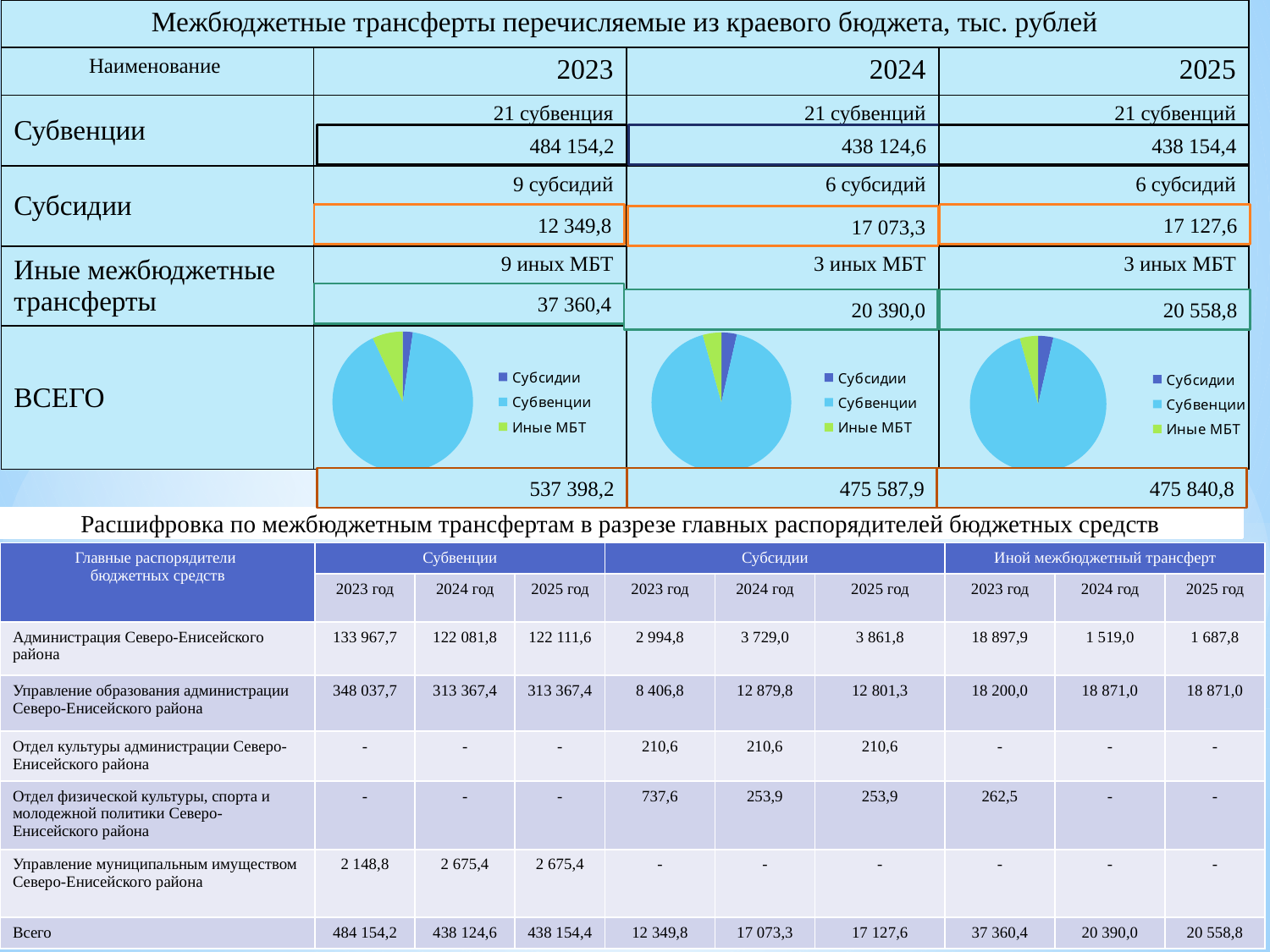
Which colour represents Иные МБТ in the pie chart legends? green What is the difference between the Субвенции and Субсидии values shown for the 2025 pie chart, in тыс. рублей? 421 026,8 How many entries does the legend of the 2024 pie chart list? 3 What is the total of all slices in the 2024 pie chart, in тыс. рублей? 475 587,9 How many pie charts are shown on the slide? 3 In the 2025 pie chart, which slice is larger: Субвенции or Иные МБТ? Субвенции In the 2023 pie chart, which category has the smallest slice? Субсидии What kind of chart is shown in the ВСЕГО row for 2023? pie chart What is the value of the Субвенции slice in the 2023 pie chart, in тыс. рублей? 484 154,2 What is the value of the Иные МБТ slice in the 2025 pie chart, in тыс. рублей? 20 558,8 Which legend entry is listed first in the 2023 pie chart legend? Субсидии In the 2023 pie chart, which category has the largest slice? Субвенции